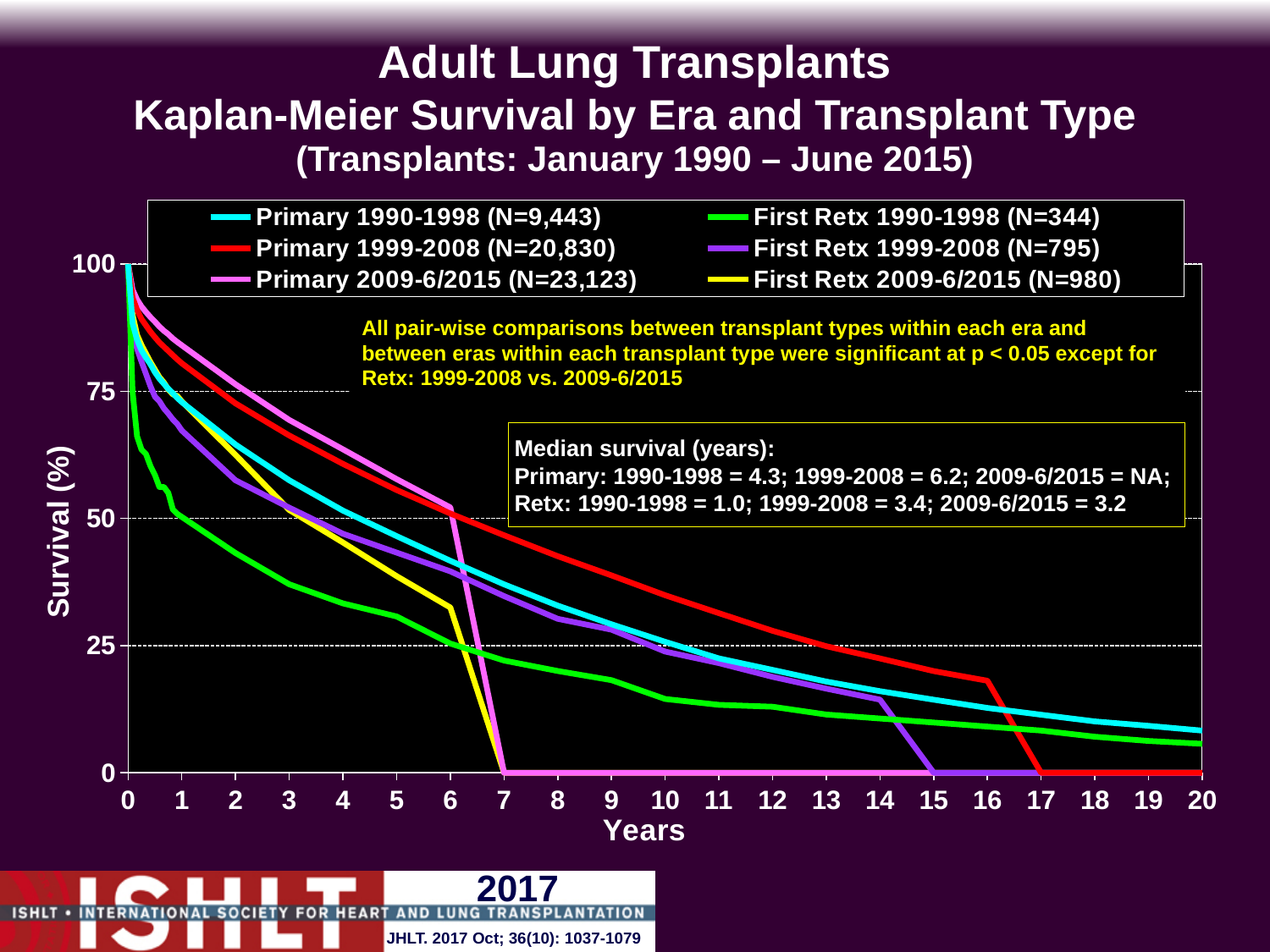
Is the survival for First Retx 1990-1998 at 3 years greater or less than 50? less What type of chart is shown on the slide? Line chart Which series has the highest survival at 15 years? Primary 1999-2008 Is the survival for Primary 1999-2008 at 10 years greater or less than 25? greater Is the survival for Primary 2009-6/2015 at 5 years greater or less than 50? greater Do the survival curves rise or fall as years increase along the x axis? Fall Which series has the lowest survival at 5 years? First Retx 1990-1998 According to the text box, what is the median survival in years for Primary transplants in 1990-1998? 4.3 At 10 years, which has higher survival: Primary 1999-2008 or First Retx 1990-1998? Primary 1999-2008 What is the N shown in the legend for Primary 1999-2008? 20,830 How many series does the legend list? 6 According to the text box, what is the median survival in years for Retx transplants in 1999-2008? 3.4